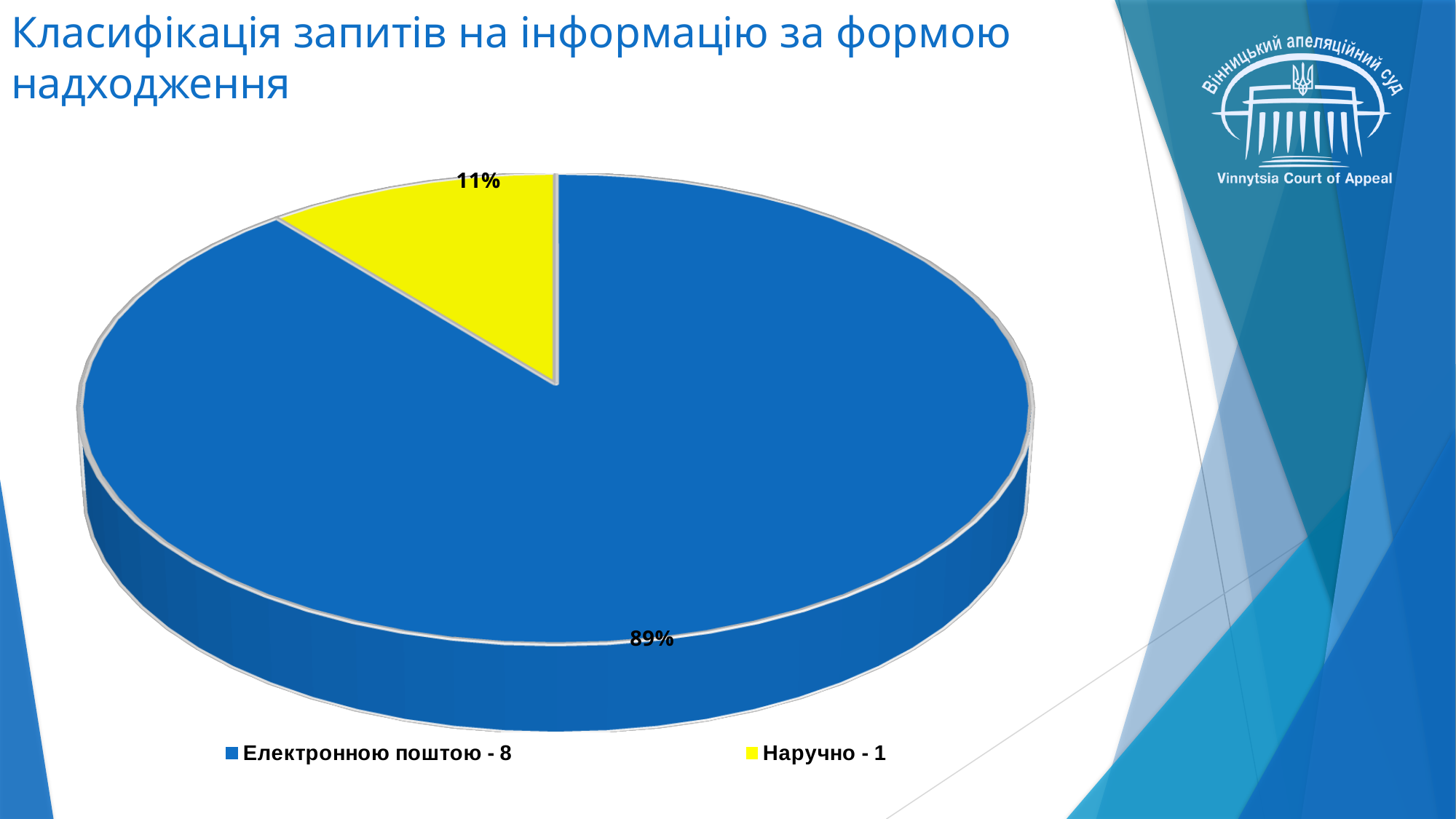
How many slices does the pie chart have? 2 What kind of chart is shown on the slide? pie chart According to the legend, how many requests were received 'Наручно'? 1 Which category has the largest share of the pie? Електронною поштою According to the legend, how many requests were received 'Електронною поштою'? 8 How many entries does the legend list? 2 What percentage share is shown for the 'Електронною поштою' slice? 89% What is the difference in percentage points between the 'Електронною поштою' and 'Наручно' shares? 78 What percentage share is shown for the 'Наручно' slice? 11% Which category has the smallest share of the pie? Наручно Which is larger: the share for 'Електронною поштою' or for 'Наручно'? Електронною поштою What colour is the 'Наручно' slice? yellow